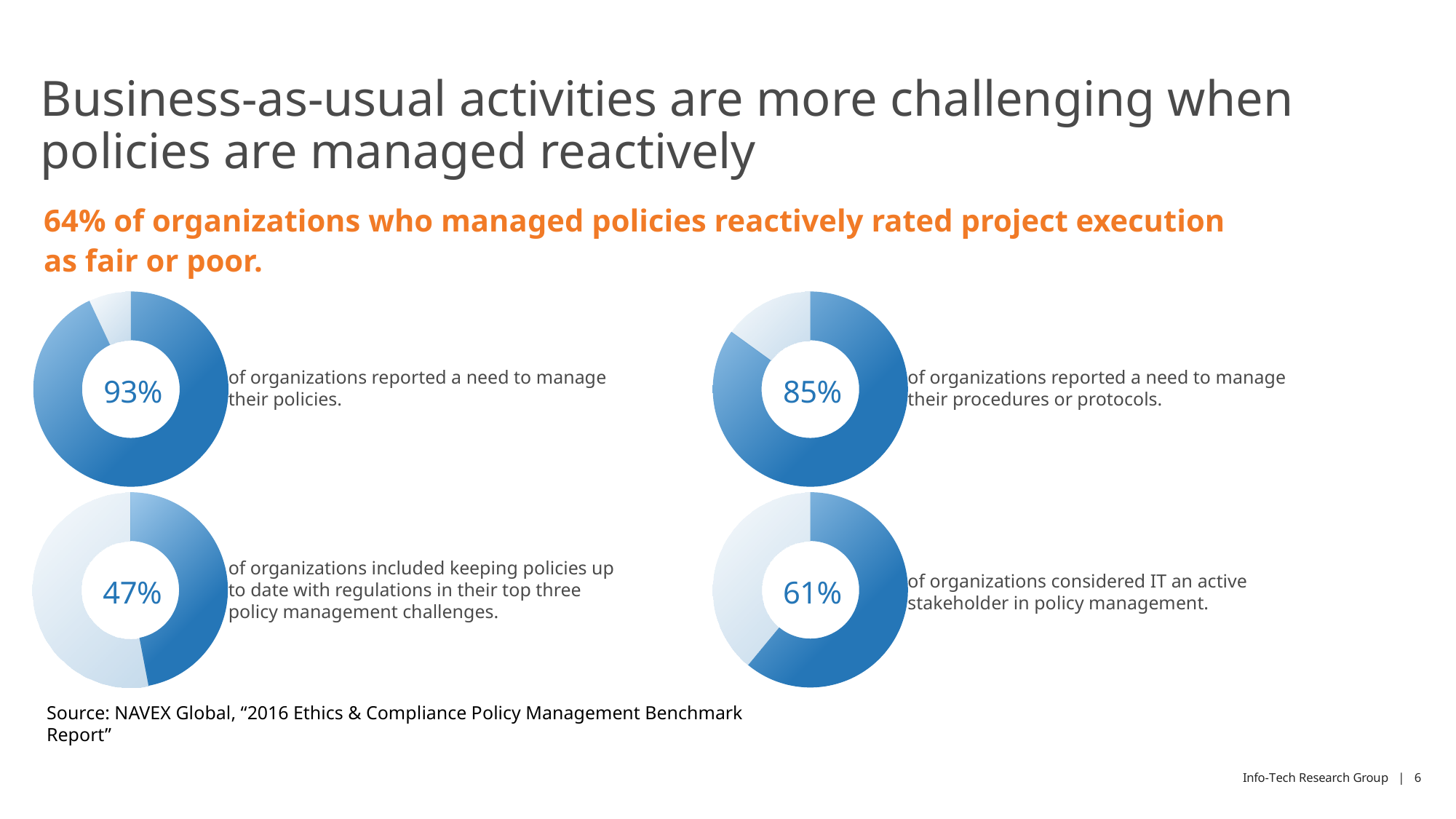
What is the difference between the percentage on the bottom-right donut chart (61%) and the percentage on the bottom-left donut chart (47%)? 14 percentage points What kind of chart is used to show each of the four percentages on the slide? Donut (pie) chart On the top-right donut chart, what percentage of organizations reported a need to manage their procedures or protocols? 85% How many donut charts are shown on the slide? 4 On the top-left donut chart, what percentage of organizations reported a need to manage their policies? 93% Which of the four donut charts shows the highest percentage? The top-left chart (93%, need to manage their policies) On the bottom-left donut chart, what percentage of organizations included keeping policies up to date with regulations in their top three policy management challenges? 47% Which of the four donut charts shows the lowest percentage? The bottom-left chart (47%, keeping policies up to date with regulations) Which is larger: the percentage of organizations that considered IT an active stakeholder (bottom-right chart) or the percentage that included keeping policies up to date with regulations in their top three challenges (bottom-left chart)? IT an active stakeholder (61%) What is the difference between the percentage on the top-left donut chart (93%) and the percentage on the top-right donut chart (85%)? 8 percentage points On the bottom-right donut chart, what percentage of organizations considered IT an active stakeholder in policy management? 61% What source is cited for the data in the donut charts? NAVEX Global, "2016 Ethics & Compliance Policy Management Benchmark Report"